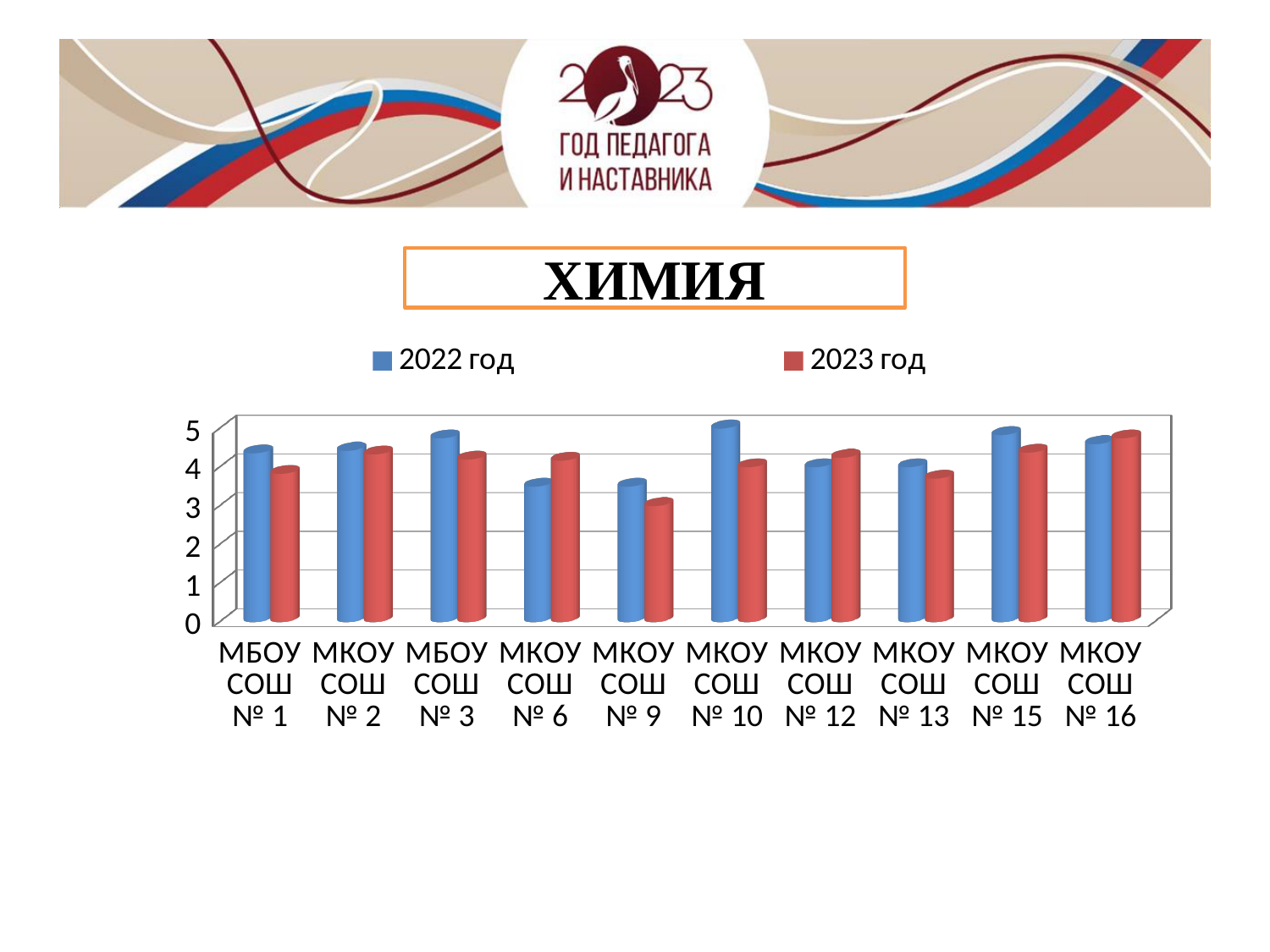
Is the 2023 год value for МКОУ СОШ № 9 greater or less than 4? less How many series does the legend list? 2 What kind of chart is shown on the slide? bar chart Which school has the lowest value for 2023 год? МКОУ СОШ № 9 What is the title of the chart? ХИМИЯ How many schools (categories) are shown on the x axis? 10 Which colour represents the 2023 год series? red Is the 2022 год value for МКОУ СОШ № 10 greater or less than 4? greater For МКОУ СОШ № 6, which year has the larger value, 2022 год or 2023 год? 2023 год For МБОУ СОШ № 1, which year has the larger value, 2022 год or 2023 год? 2022 год Which school has the highest value for 2022 год? МКОУ СОШ № 10 Is the 2022 год value for МКОУ СОШ № 6 greater or less than 4? less